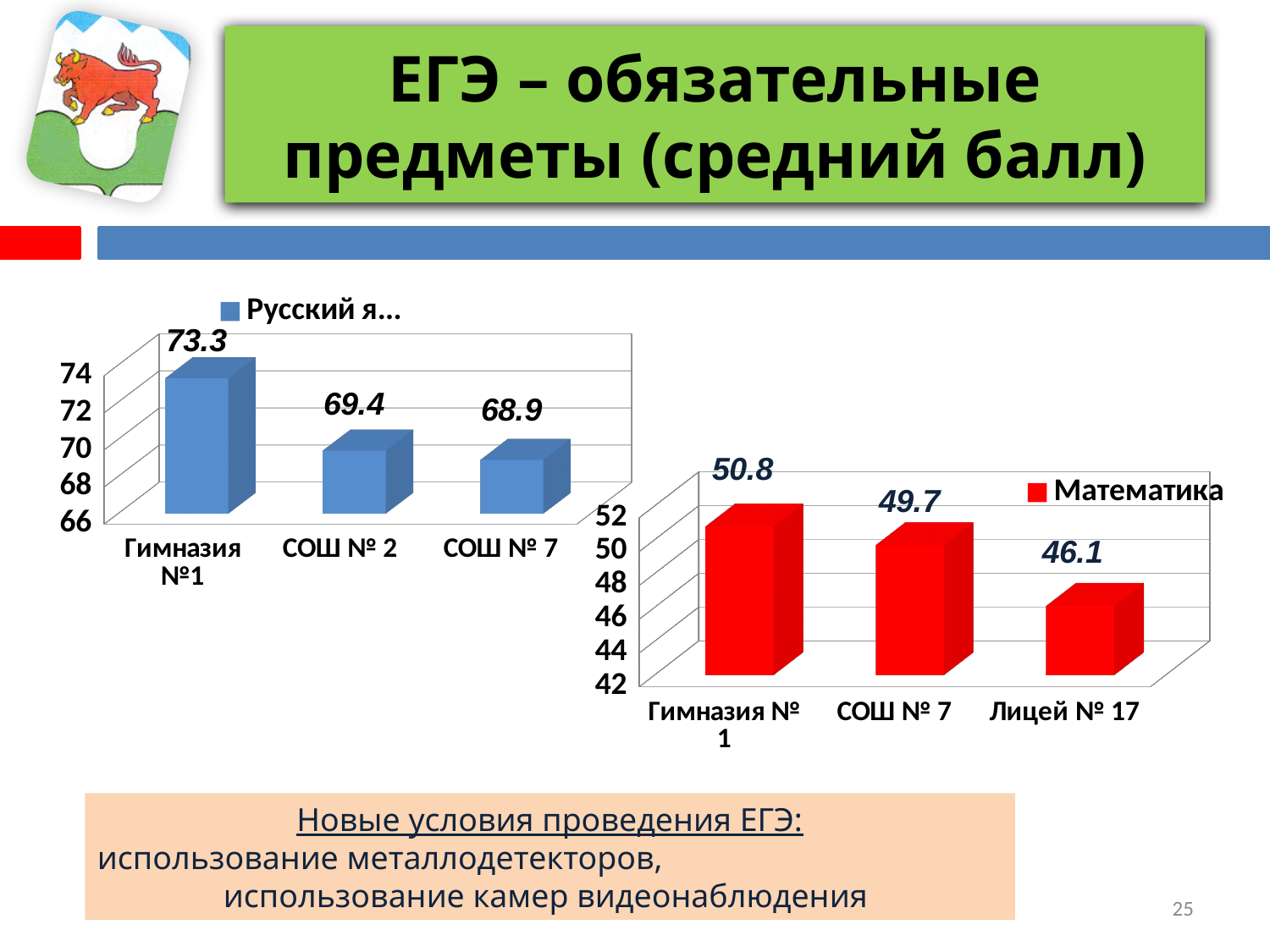
In the right chart (Математика), do the values rise or fall from left to right along the x axis? Fall How many categories are shown in the right chart (Математика)? 3 In the right chart (Математика), what is the value for Лицей № 17? 46.1 In the right chart (Математика), what is the difference between the values for Гимназия № 1 and Лицей № 17? 4.7 In the left chart (blue bars), what is the difference between the values for Гимназия №1 and СОШ № 7? 4.4 In the right chart (Математика), which category has the lowest value? Лицей № 17 In the right chart (Математика), which is larger: the value for Гимназия № 1 or the value for СОШ № 7? Гимназия № 1 In the left chart (blue bars), what is the value for СОШ № 2? 69.4 What type of chart is the left chart (blue bars)? Bar chart In the right chart (Математика), what is the value for СОШ № 7? 49.7 In the left chart (blue bars), what is the value for Гимназия №1? 73.3 In the left chart (blue bars), which category has the highest value? Гимназия №1